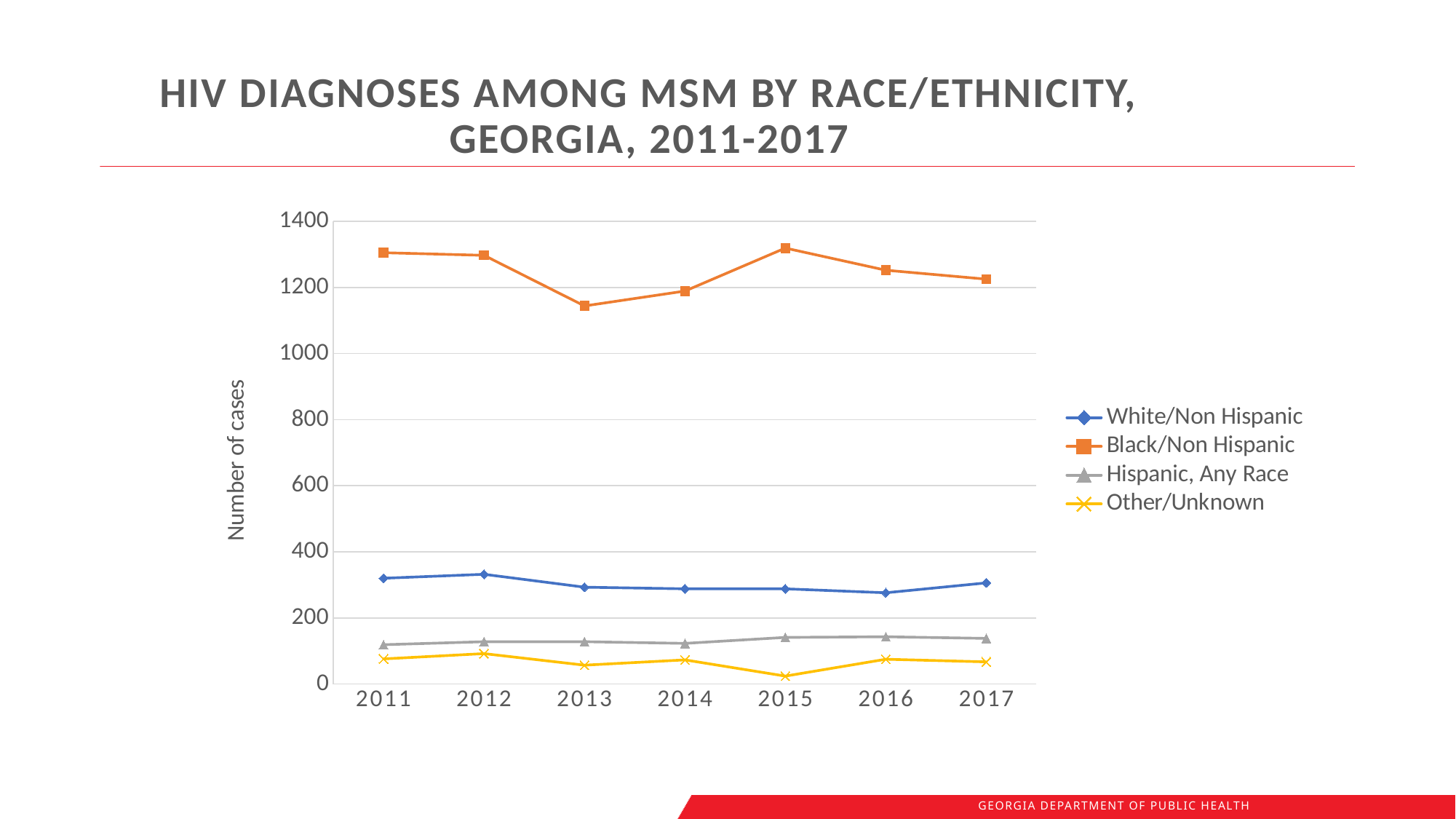
Is the value for Black/Non Hispanic in 2015 greater or less than 1200? greater In which year is the Other/Unknown series at its lowest? 2015 Which series has the highest number of cases across all years? Black/Non Hispanic What is the label on the y axis? Number of cases Is the value for Black/Non Hispanic in 2013 greater or less than 1200? less What kind of chart is shown on the slide? line chart Which is larger for Black/Non Hispanic: the value in 2011 or the value in 2013? 2011 How many series does the legend list? 4 In which year is the Black/Non Hispanic series at its lowest? 2013 How many years are plotted along the x axis? 7 Is the value for White/Non Hispanic in 2012 greater or less than 400? less Which series has the lowest number of cases across all years? Other/Unknown